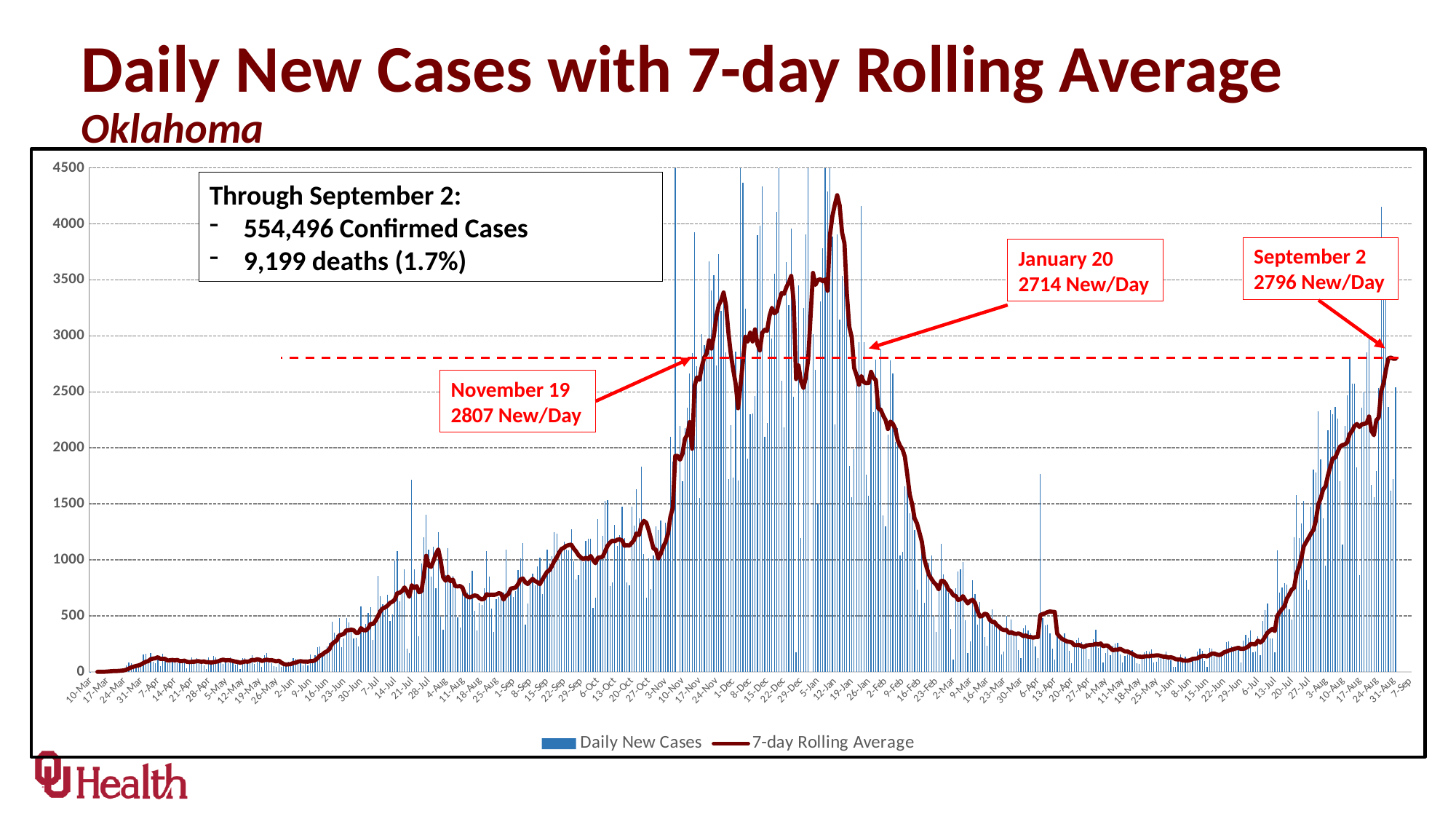
What was the 7-day rolling average of new cases per day on September 2, according to the annotation? 2796 New/Day What are the two entries in the chart legend? Daily New Cases; 7-day Rolling Average What was the 7-day rolling average of new cases per day on January 20, according to the annotation? 2714 New/Day What is the difference between the annotated rolling averages for September 2 and January 20? 82 Of the three annotated dates, which has the lowest rolling average value? January 20 Is the peak of the 7-day rolling average line in mid-January greater or less than 4000? greater Which annotated date had the larger rolling average: November 19 or January 20? November 19 How many series does the legend list? 2 Of the three annotated dates, which has the highest rolling average value? November 19 What was the 7-day rolling average of new cases per day on November 19, according to the annotation? 2807 New/Day Is the 7-day rolling average around 1-Jun (2021) greater or less than 500? less How much higher was the annotated rolling average on November 19 than on September 2? 11